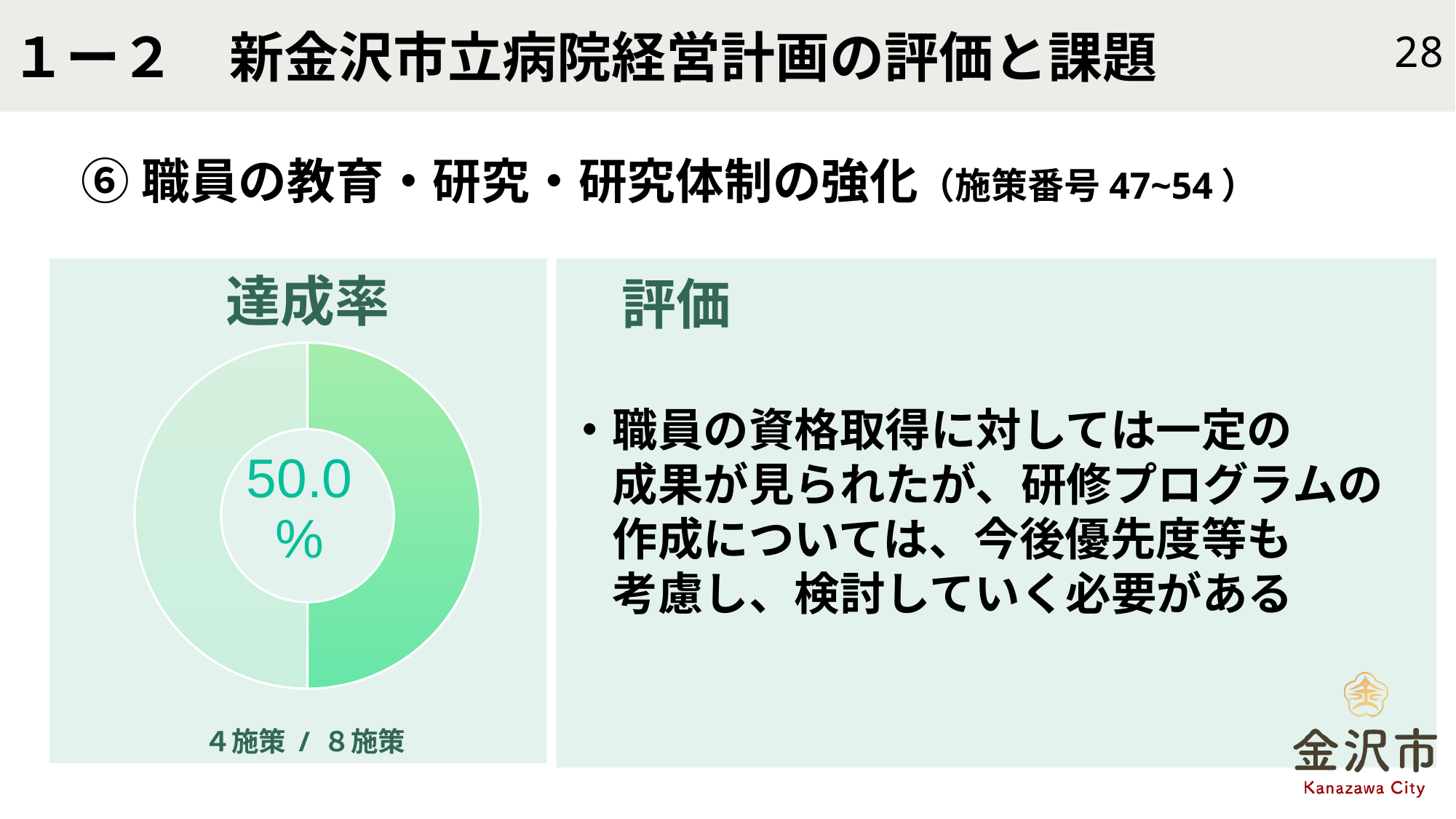
What share of the donut chart does the darker green (achieved) slice represent? 50.0% What is the title of the chart on the left of the slide? 達成率 What value is printed in the centre of the donut chart? 50.0% What kind of chart is shown on the slide? Pie chart (donut) What colour is the achieved portion of the donut chart? Green How many slices does the donut chart have? 2 What is the difference between the total number of measures and the number achieved, as shown below the chart? 4 According to the label below the chart, how many measures are there in total? 8施策 According to the label below the chart, how many measures were achieved? 4施策